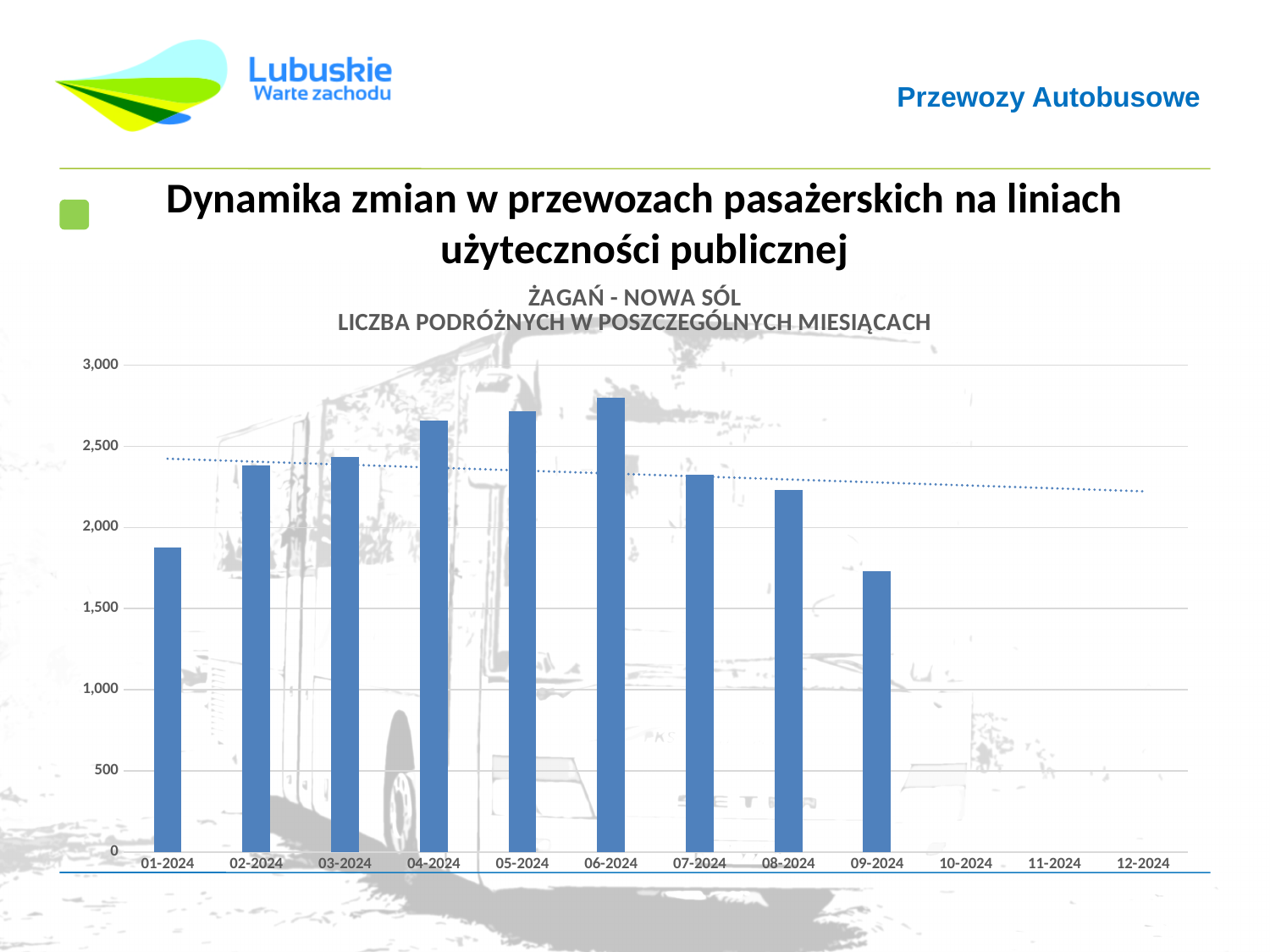
Does the dotted trend line rise or fall from left to right? fall Is the value for 06-2024 greater or less than 2,500? greater How many months have a bar plotted on the chart? 9 Is the value for 01-2024 greater or less than 2,000? less Is the value for 09-2024 greater or less than 2,000? less Which route is named in the chart title? ŻAGAŃ - NOWA SÓL Which month with a plotted bar has the lowest number of passengers? 09-2024 What kind of chart is shown on the slide? bar chart Which is larger, the value for 07-2024 or the value for 05-2024? 05-2024 Which month has the highest number of passengers? 06-2024 Which is larger, the value for 04-2024 or the value for 02-2024? 04-2024